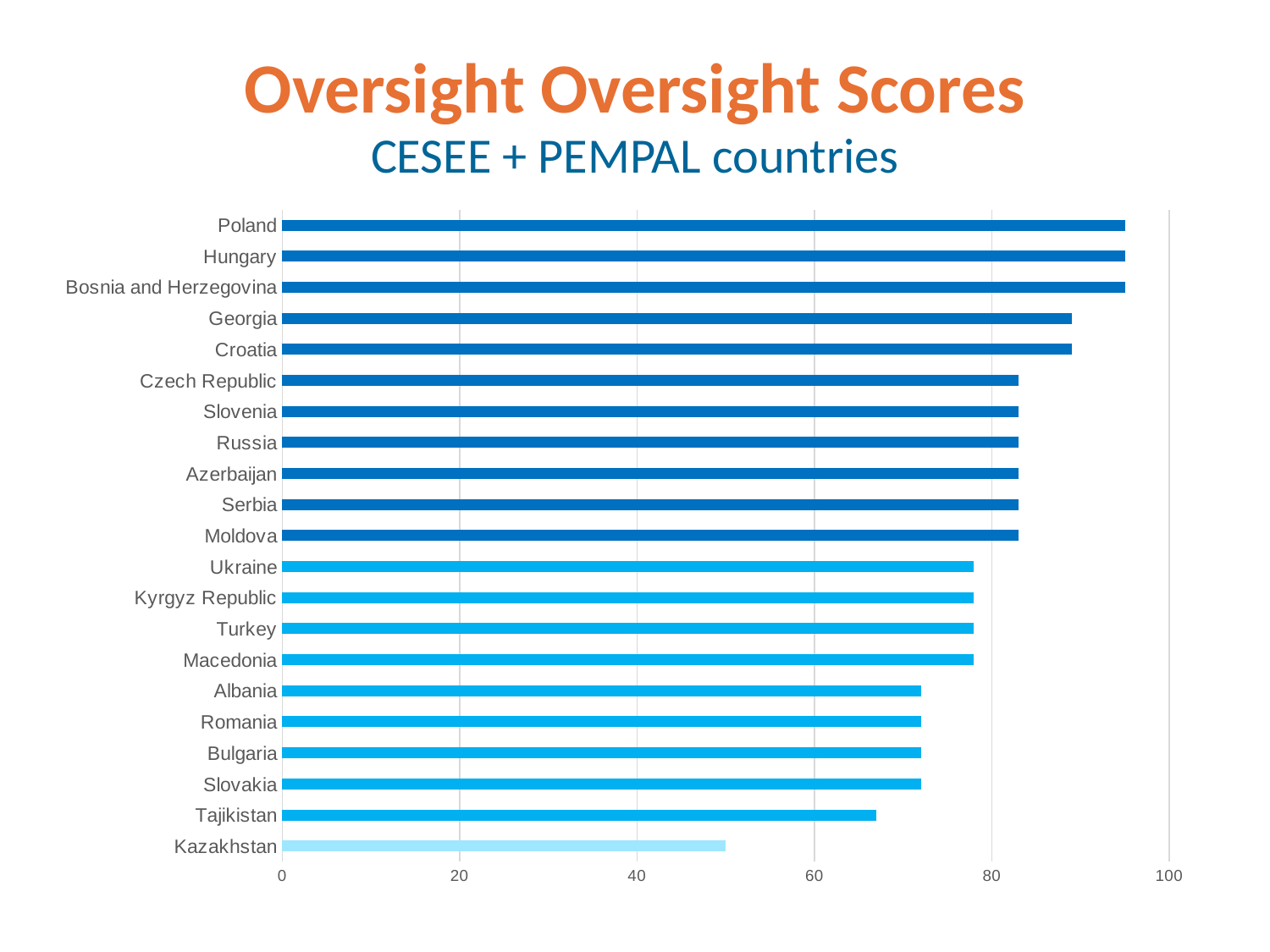
Which has the larger value, Kazakhstan or Romania? Romania Is the value for Tajikistan greater or less than 60? greater What is the highest value shown on the horizontal axis? 100 Is the value for Poland greater or less than 80? greater Which country has the lowest oversight score? Kazakhstan Is the value for Czech Republic greater or less than 60? greater How many countries are plotted in the chart? 21 Which has the larger value, Georgia or Tajikistan? Georgia What kind of chart is shown on the slide? bar chart What is the subtitle shown below the chart title? CESEE + PEMPAL countries